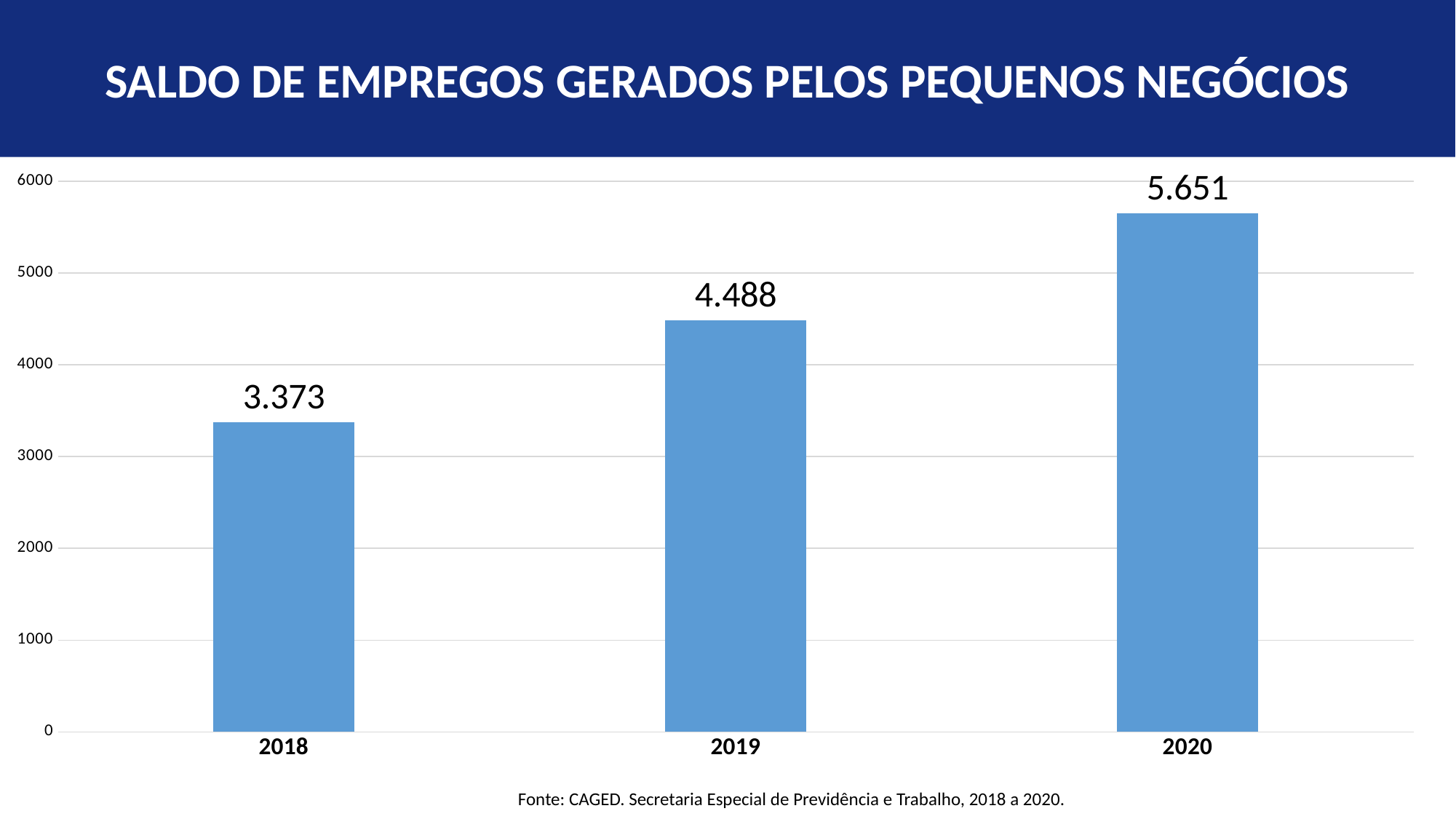
What kind of chart is shown on the slide? bar chart What is the difference between the values for 2020 and 2019? 1.163 Do the values rise or fall from 2018 to 2020? rise How many years are shown on the x axis? 3 What is the value shown for 2018? 3.373 What is the difference between the values for 2019 and 2018? 1.115 What is the value shown for 2020? 5.651 Which year has the highest value? 2020 What is the value shown for 2019? 4.488 Which year has the lowest value? 2018 Is the value for 2020 greater or less than 5000? greater Which is larger, the value for 2018 or the value for 2019? 2019